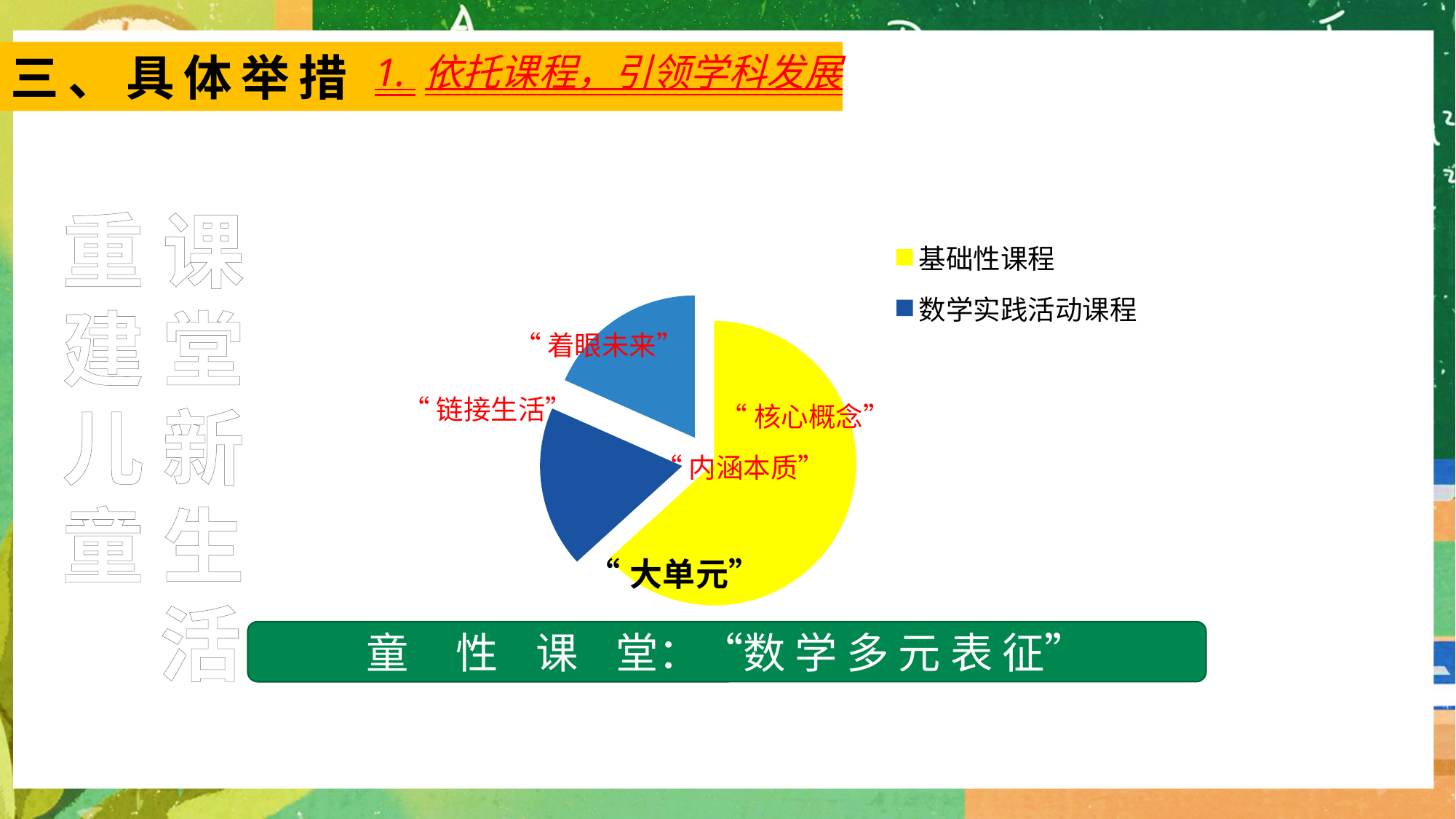
What kind of chart is shown on the slide? pie chart What colour represents 基础性课程 in the legend? yellow What is the second entry listed in the chart legend? 数学实践活动课程 How many entries does the chart legend list? 2 Does the yellow slice (基础性课程) take up more or less than half of the pie? more How many slices does the pie chart have? 3 Which legend category has the largest slice of the pie? 基础性课程 Which is larger: the yellow slice or the dark blue slice? the yellow slice